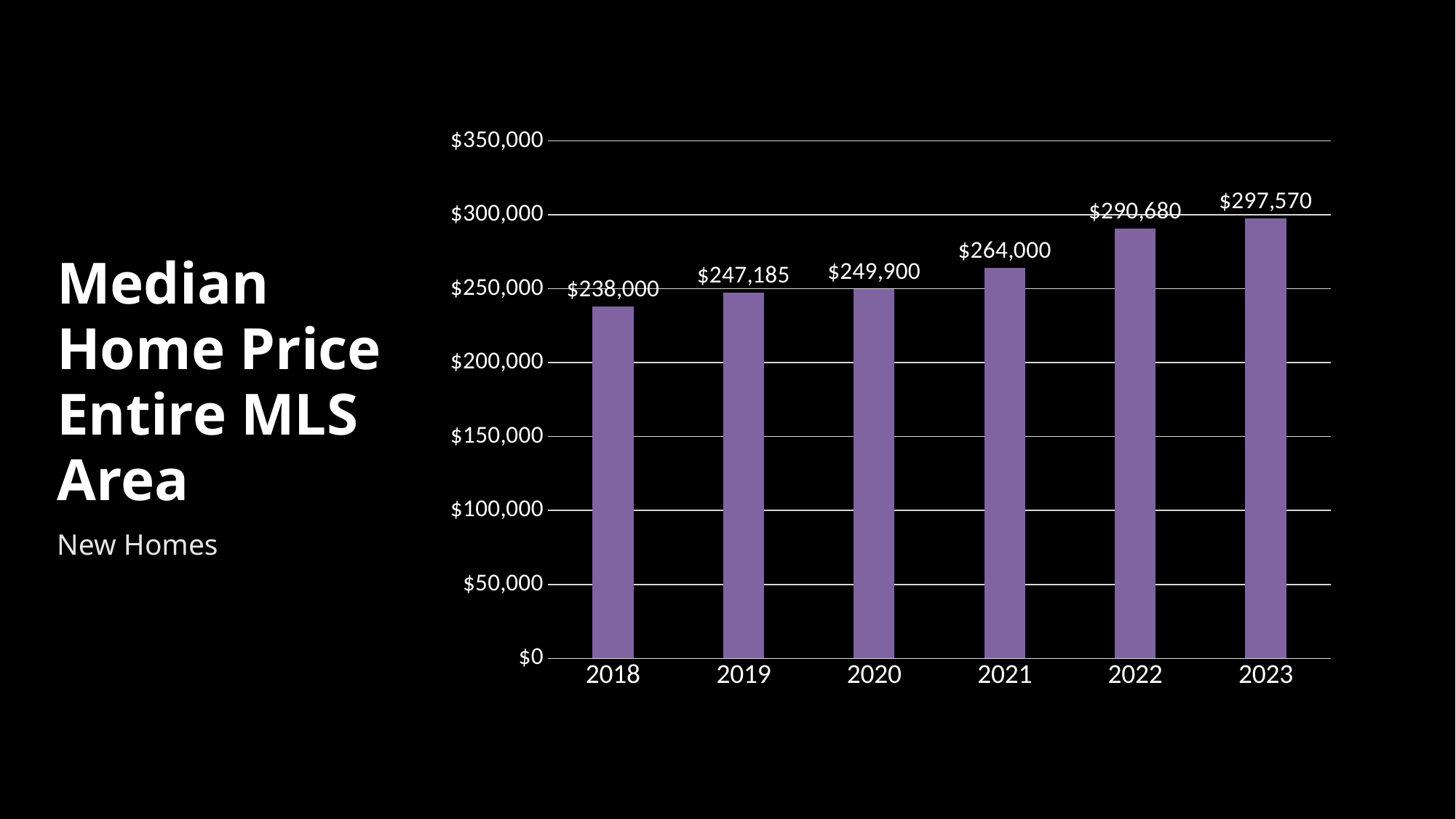
What is the median home price for 2018? $238,000 What kind of chart is shown on the slide? bar chart Do the median home prices rise or fall from 2018 to 2023? rise Which year has the lowest median home price? 2018 Is the median home price for 2020 greater or less than $300,000? less What is the difference between the median home price in 2021 and in 2020? $14,100 How many years are shown on the chart? 6 What is the median home price for 2021? $264,000 Which year has a higher median home price, 2019 or 2022? 2022 Which year has the highest median home price? 2023 What is the median home price for 2023? $297,570 What is the difference between the median home price in 2023 and in 2022? $6,890